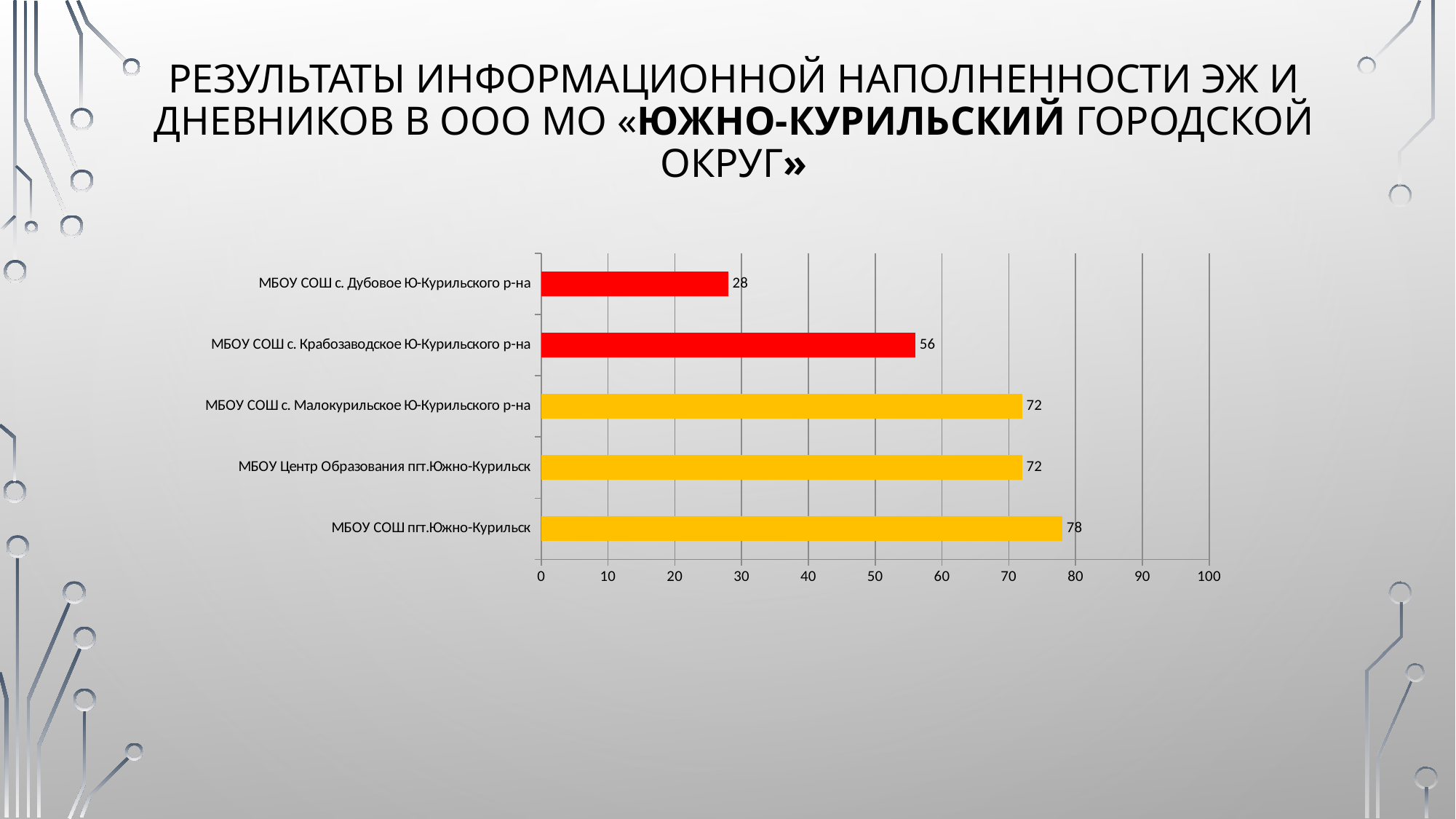
What is the value for МБОУ СОШ с. Крабозаводское Ю-Курильского р-на? 56 How many categories are shown in the chart? 5 What kind of chart is shown on the slide? Bar chart What is the value for МБОУ СОШ с. Дубовое Ю-Курильского р-на? 28 Which is larger, the value for МБОУ СОШ с. Малокурильское Ю-Курильского р-на or the value for МБОУ СОШ с. Крабозаводское Ю-Курильского р-на? МБОУ СОШ с. Малокурильское Ю-Курильского р-на What is the value for МБОУ Центр Образования пгт.Южно-Курильск? 72 Which category has the lowest value? МБОУ СОШ с. Дубовое Ю-Курильского р-на What is the difference between the values for МБОУ СОШ с. Крабозаводское Ю-Курильского р-на and МБОУ СОШ с. Дубовое Ю-Курильского р-на? 28 Which category has the highest value? МБОУ СОШ пгт.Южно-Курильск What is the difference between the values for МБОУ СОШ пгт.Южно-Курильск and МБОУ СОШ с. Дубовое Ю-Курильского р-на? 50 What colour are the bars for the two categories with the lowest values? Red What is the value for МБОУ СОШ пгт.Южно-Курильск? 78